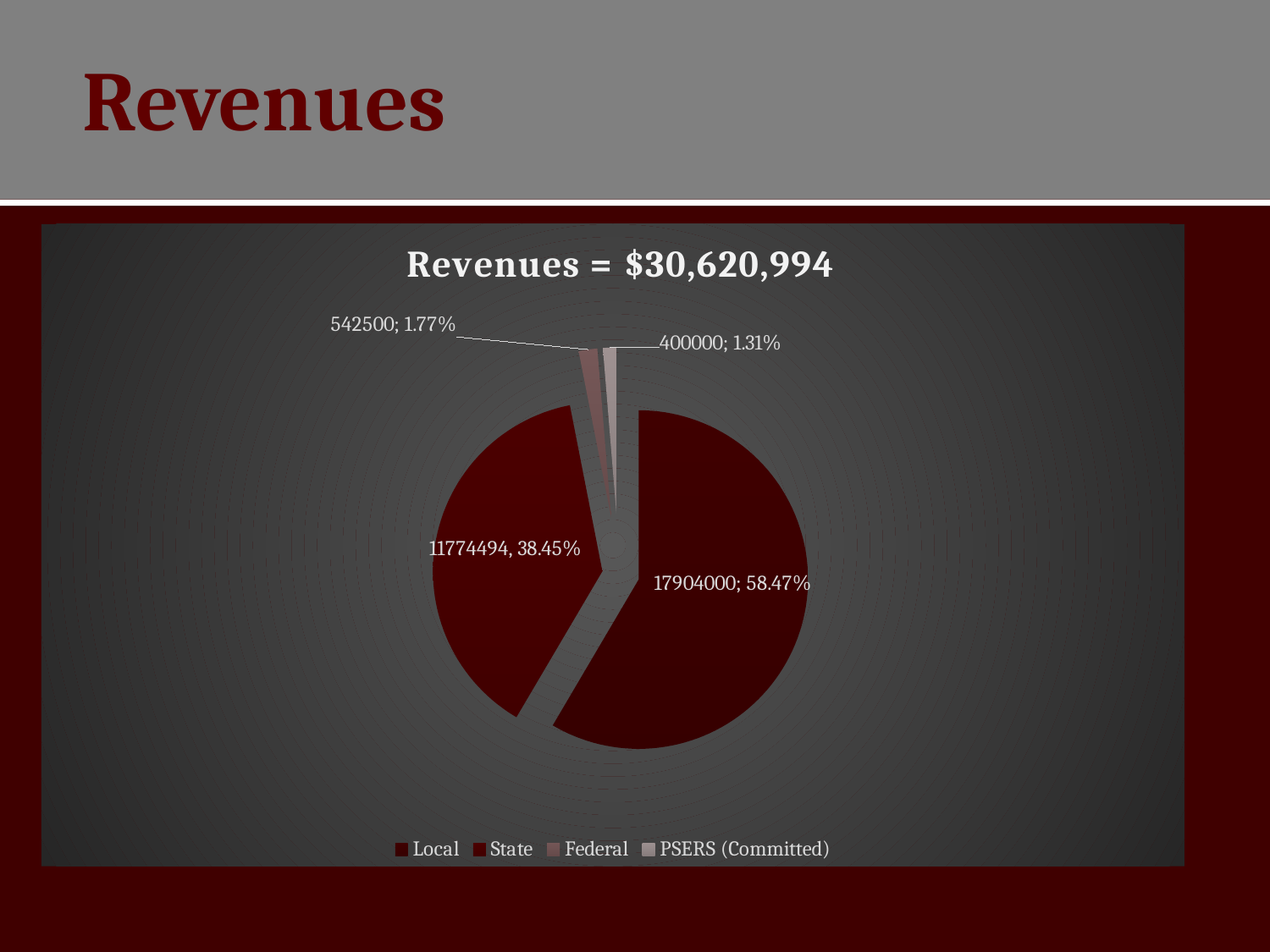
What is the value shown for the Federal slice? 542500 Which category has the largest slice of the pie? Local What is the difference between the Local value and the State value? 6129506 How many entries does the legend list? 4 What type of chart is shown on the slide? pie chart What is the value shown for the Local slice? 17904000 Which is larger, the Federal value or the PSERS (Committed) value? Federal What is the title of the chart? Revenues = $30,620,994 How many slices does the pie chart have? 4 What percentage share does the State slice have? 38.45% What percentage share does the PSERS (Committed) slice have? 1.31% Which category has the smallest slice of the pie? PSERS (Committed)